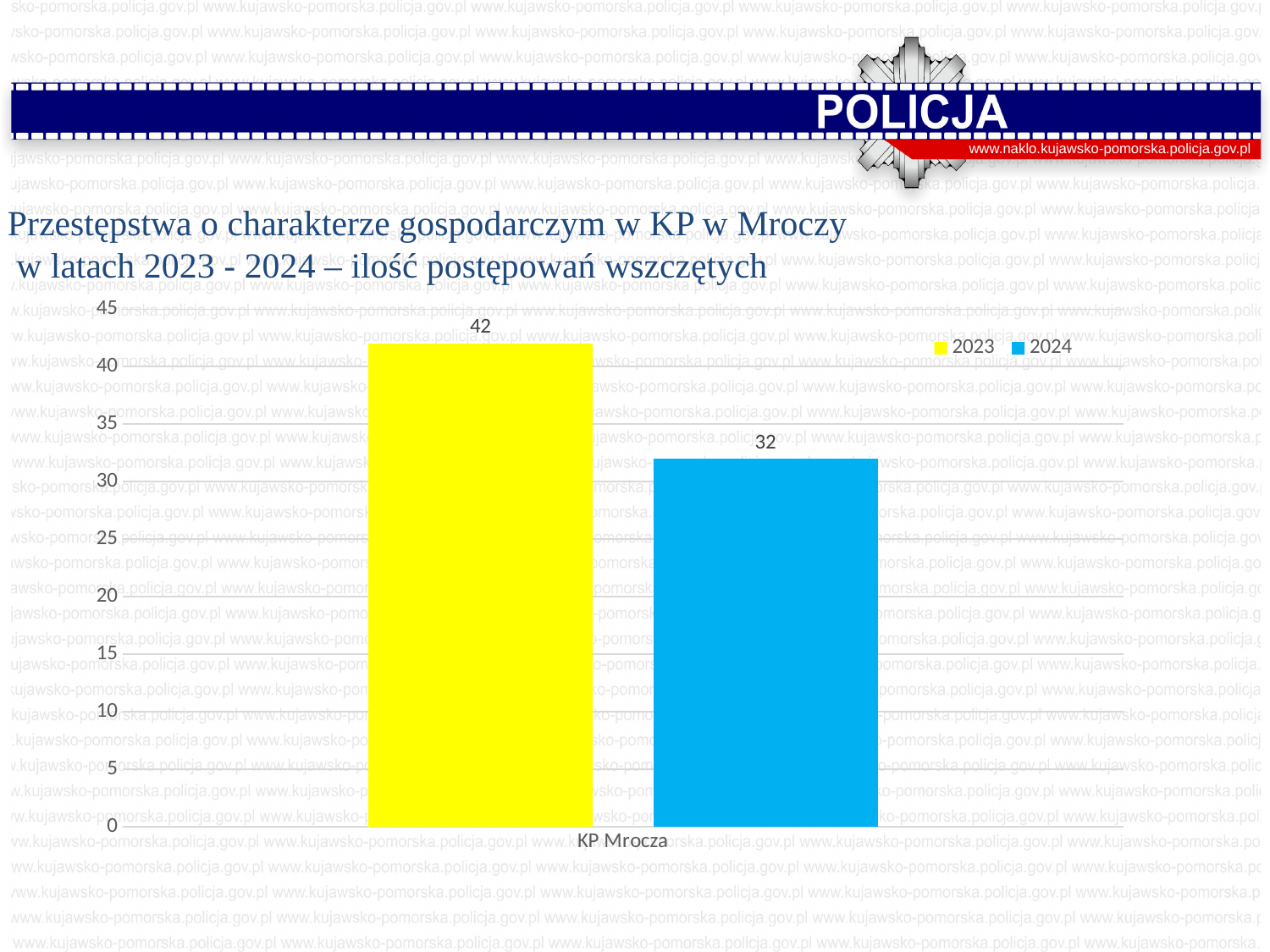
Which colour represents the 2024 series in the legend? blue What is the difference between the 2023 and 2024 values? 10 How many series does the legend list? 2 Do the values fall or rise from 2023 to 2024? fall Which series has the lowest value in the chart? 2024 What kind of chart is shown on the slide? bar chart Is the value for 2024 greater or less than 35? less What is the value for 2023 in the chart? 42 What is the category label shown on the x axis? KP Mrocza What is the value for 2024 in the chart? 32 Which year has the higher value, 2023 or 2024? 2023 Is the value for 2023 greater or less than 40? greater